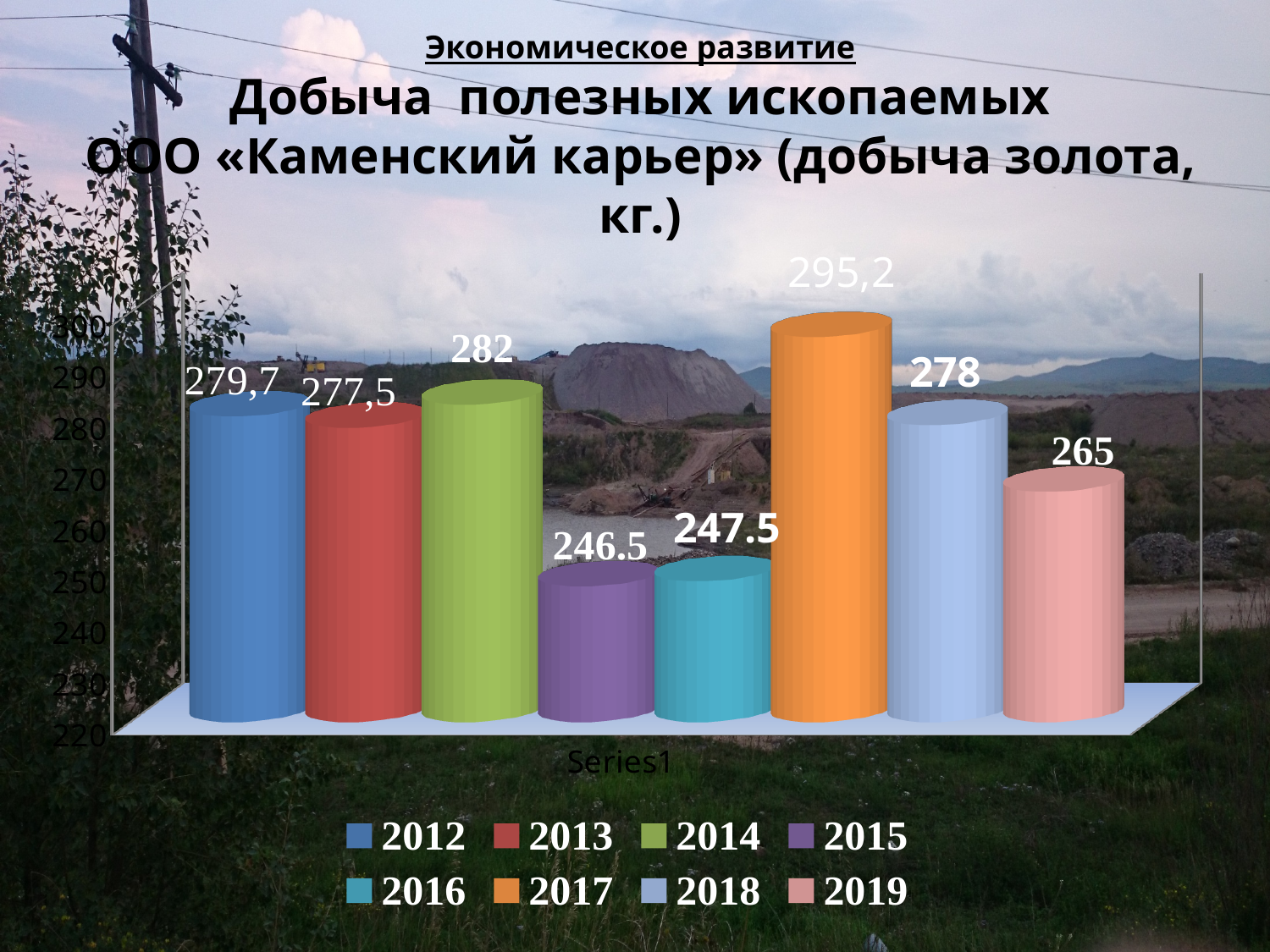
What is the value for 2017? 295,2 What kind of chart is shown on the slide? bar chart What is the value for 2015? 246.5 How many entries does the legend list? 8 How many bars are plotted in the chart? 8 What is the value for 2012? 279,7 Which is larger, the value for 2014 or the value for 2018? 2014 Is the value for 2016 greater or less than 250? less What is the difference between the values for 2014 and 2019? 17 Which year has the highest value? 2017 What is the difference between the values for 2018 and 2019? 13 Which year has the lowest value? 2015